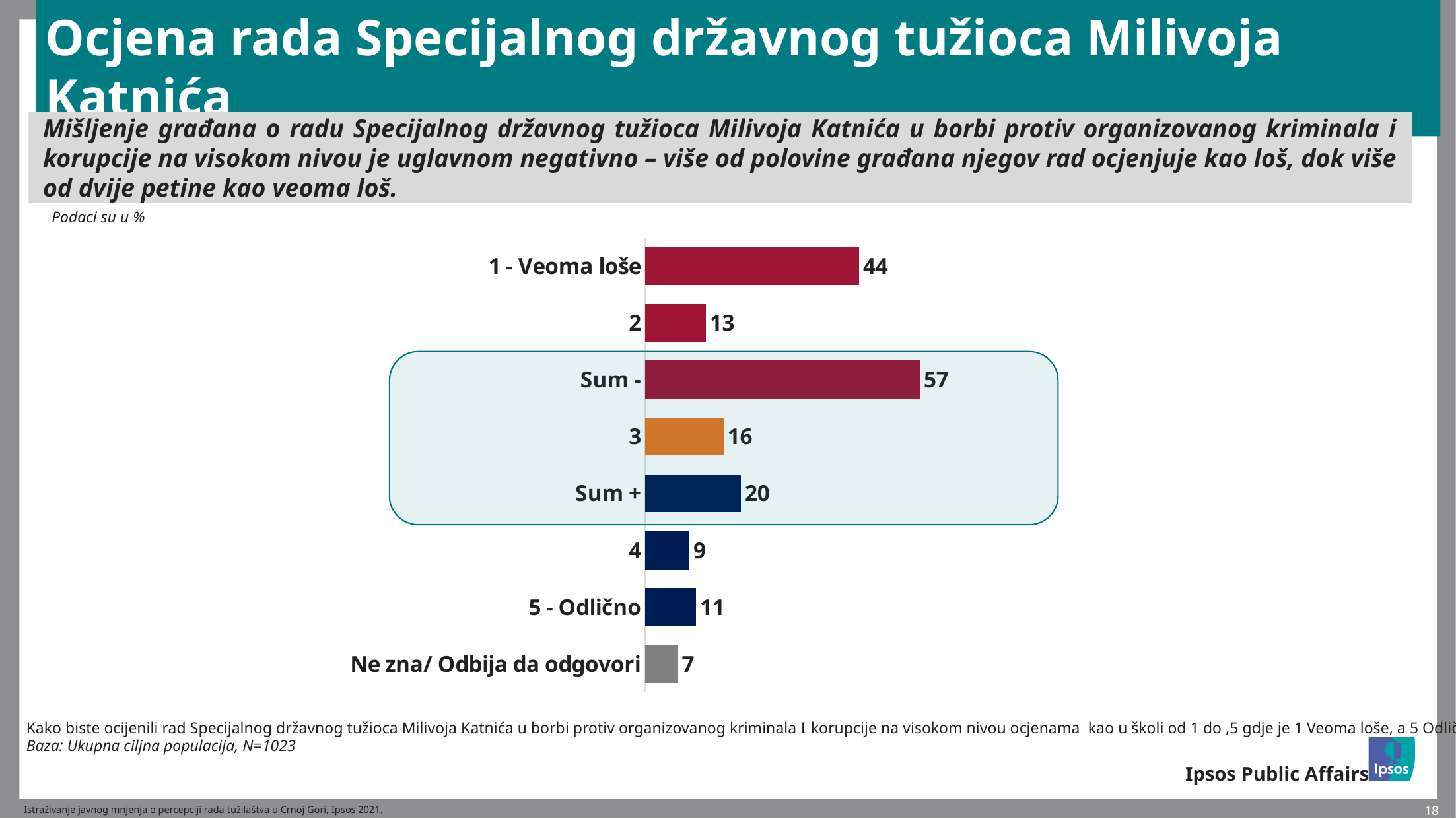
How many categories are shown in the chart? 8 What kind of chart is shown on the slide? Bar chart What is the difference between the values for "Sum -" and "Sum +"? 37 What colour is the bar for category "3"? Orange What is the difference between the values for "1 - Veoma loše" and "5 - Odlično"? 33 Which is larger, the value for "3" or the value for "2"? 3 Which category has the lowest value? Ne zna/ Odbija da odgovori Which category has the highest value? Sum - What is the value for "1 - Veoma loše"? 44 What is the value for "Ne zna/ Odbija da odgovori"? 7 What is the value for "Sum +"? 20 What is the value for "Sum -"? 57